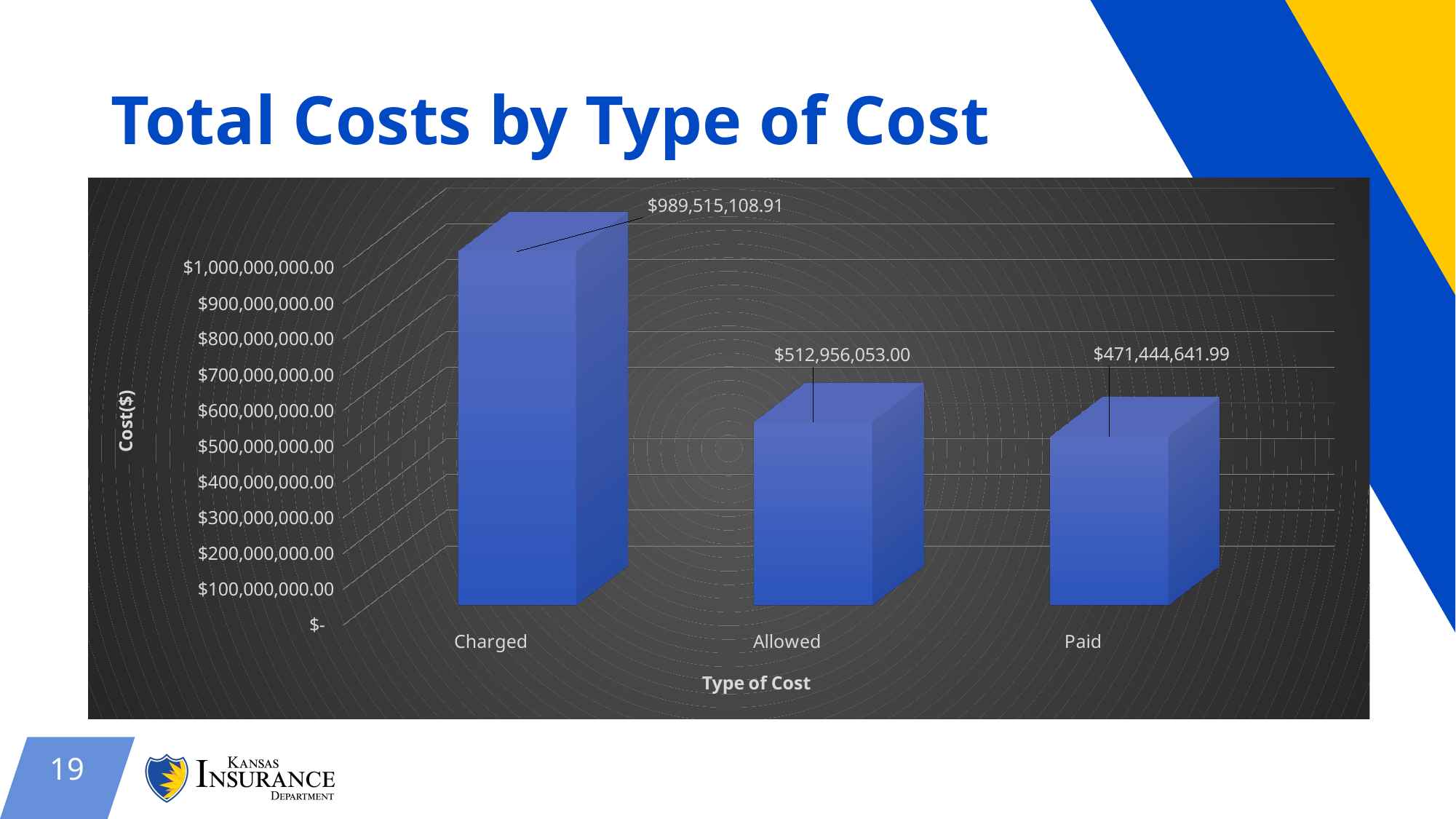
What is the value for Allowed? $512,956,053.00 Which type of cost has the lowest total cost? Paid Is the value for Charged greater or less than $900,000,000.00? greater What is the difference between the Allowed and Paid values? $41,511,411.01 Which type of cost has the highest total cost? Charged What is the difference between the Charged and Allowed values? $476,559,055.91 What is the value for Paid? $471,444,641.99 Which is larger, the value for Allowed or the value for Paid? Allowed What is the value for Charged? $989,515,108.91 What kind of chart is shown on the slide? Bar chart How many types of cost are shown on the chart? 3 What is the label of the vertical axis? Cost($)